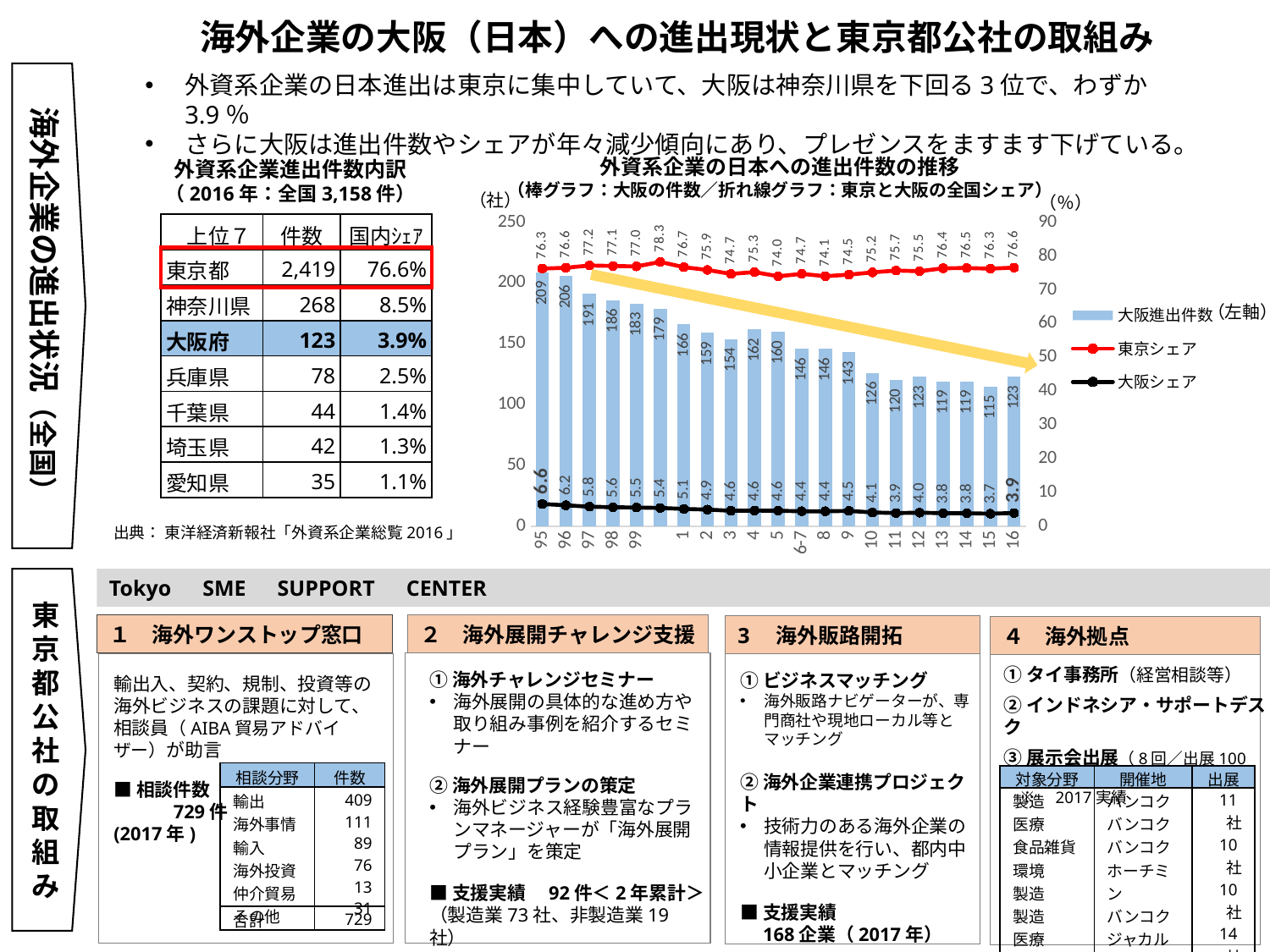
How many series does the legend list? 3 What is the difference in 大阪進出件数 between 95 and 16? 86 What is the overall trend of 大阪シェア from 95 to 16? Falling What is the title of the chart? 外資系企業の日本への進出件数の推移 Which year has the highest 東京シェア? 2000 Which year has the highest 大阪進出件数? 95 What is the 大阪シェア value for 95? 6.6 What is the value of 大阪進出件数 for 16? 123 Which is larger, the 大阪進出件数 for 10 or for 12? 10 Which year has the lowest 大阪進出件数? 15 What is the 東京シェア value for 16? 76.6 What is the value of 大阪進出件数 for 95? 209